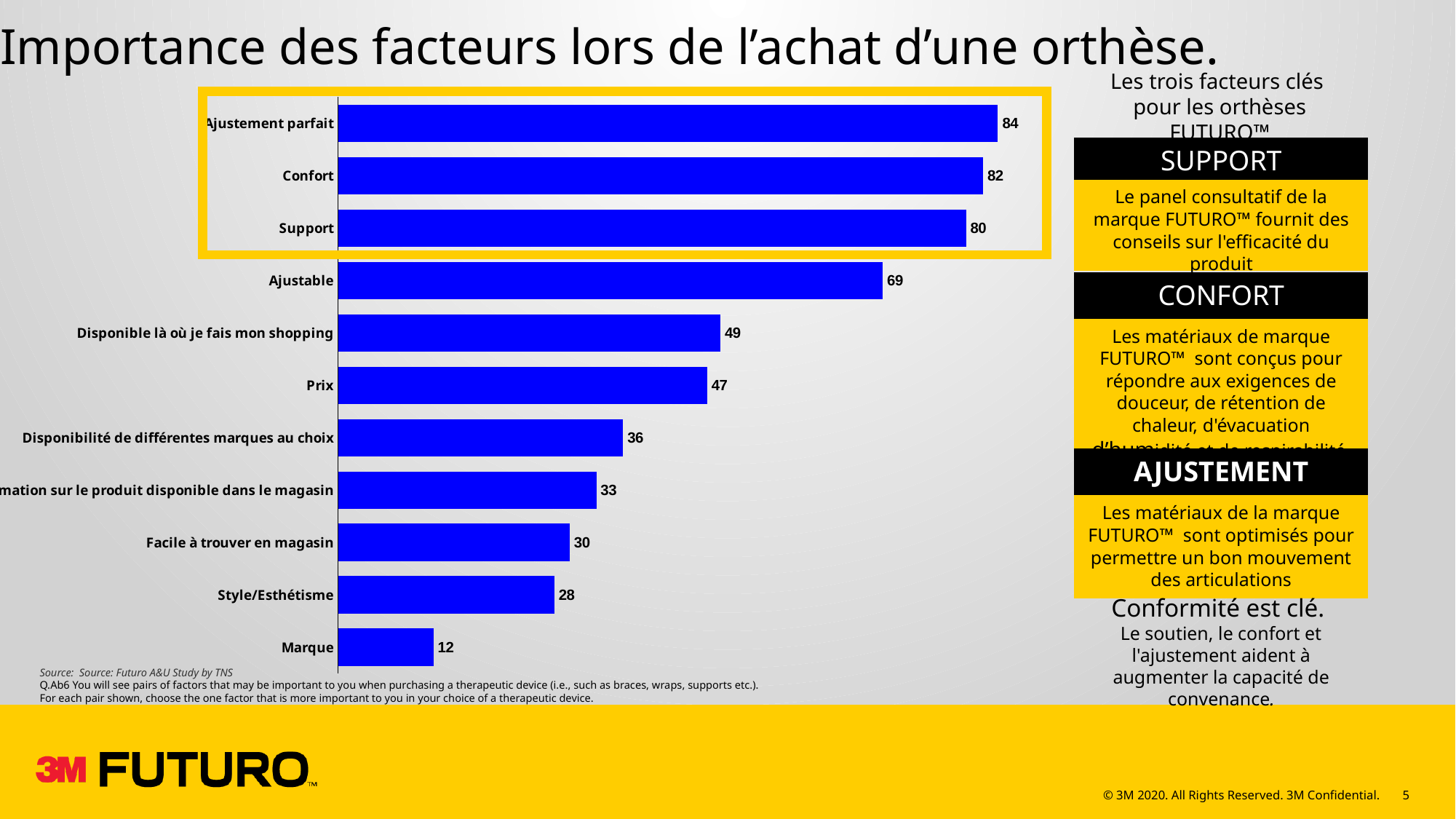
How many categories are shown in the chart? 11 What is the difference between the values for Confort and Support? 2 Which is larger, the value for Disponible là où je fais mon shopping or the value for Prix? Disponible là où je fais mon shopping Which is larger, the value for Facile à trouver en magasin or the value for Disponibilité de différentes marques au choix? Disponibilité de différentes marques au choix What is the value for Style/Esthétisme? 28 What colour are the bars in the chart? Blue What is the difference between the values for Ajustable and Marque? 57 What kind of chart is shown on the slide? Bar chart What is the value for Prix? 47 What is the value for Ajustement parfait? 84 Which category has the highest value? Ajustement parfait Which category has the lowest value? Marque